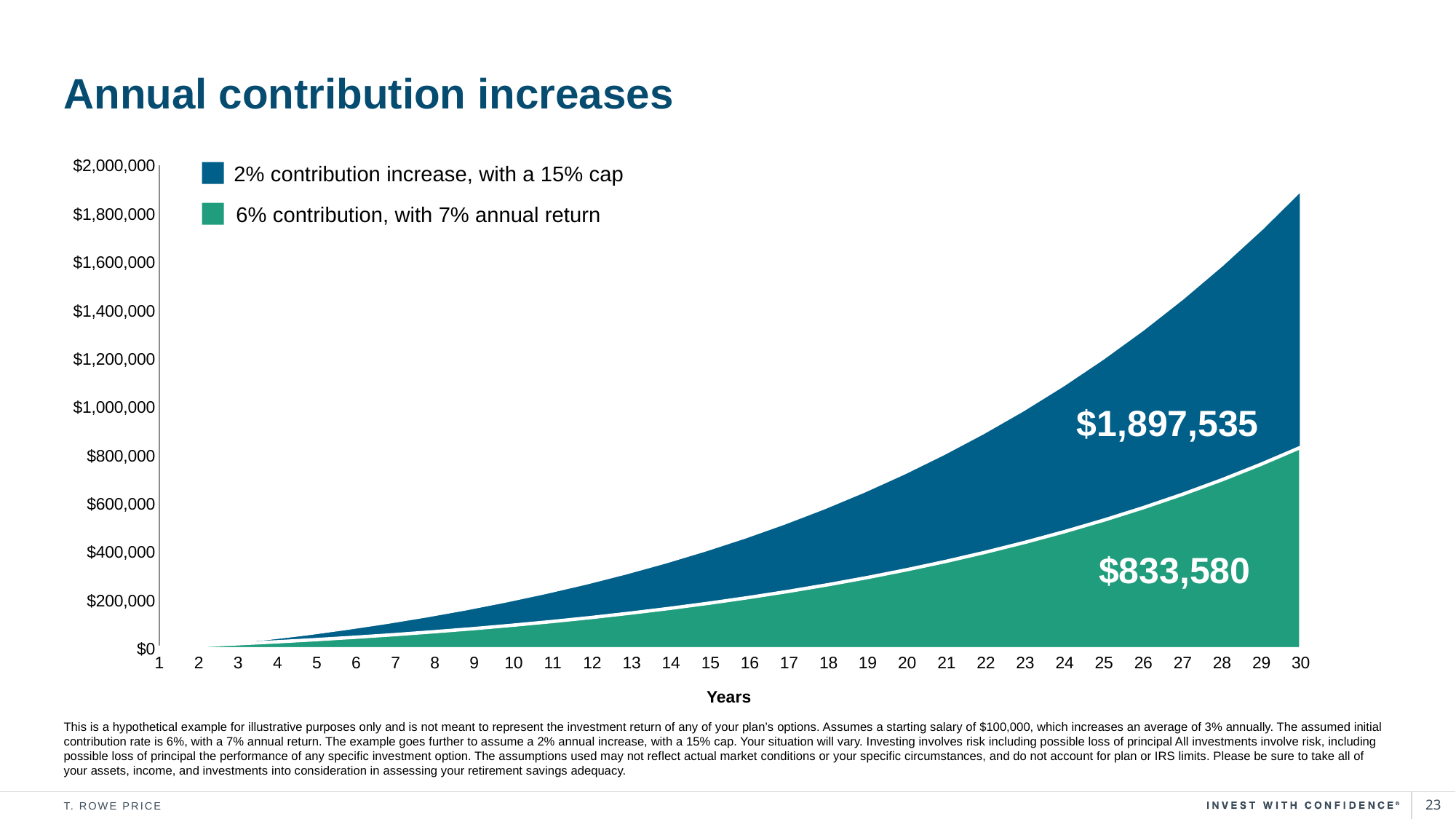
At year 30, which series has the larger value: "2% contribution increase, with a 15% cap" or "6% contribution, with 7% annual return"? 2% contribution increase, with a 15% cap Do the values rise or fall as the years increase along the x axis? Rise What is the label of the x axis? Years What is the value at year 30 for the "2% contribution increase, with a 15% cap" series? $1,897,535 What is the value at year 30 for the "6% contribution, with 7% annual return" series? $833,580 What is the difference between the two labelled year-30 values, $1,897,535 and $833,580? $1,063,955 What is the title of the chart? Annual contribution increases How many years are shown along the x axis? 30 Is the year-30 value for the "6% contribution, with 7% annual return" series greater or less than $1,000,000? less Is the year-30 value for the "2% contribution increase, with a 15% cap" series greater or less than $1,800,000? greater How many series does the legend list? 2 What kind of chart is shown on the slide? Area chart